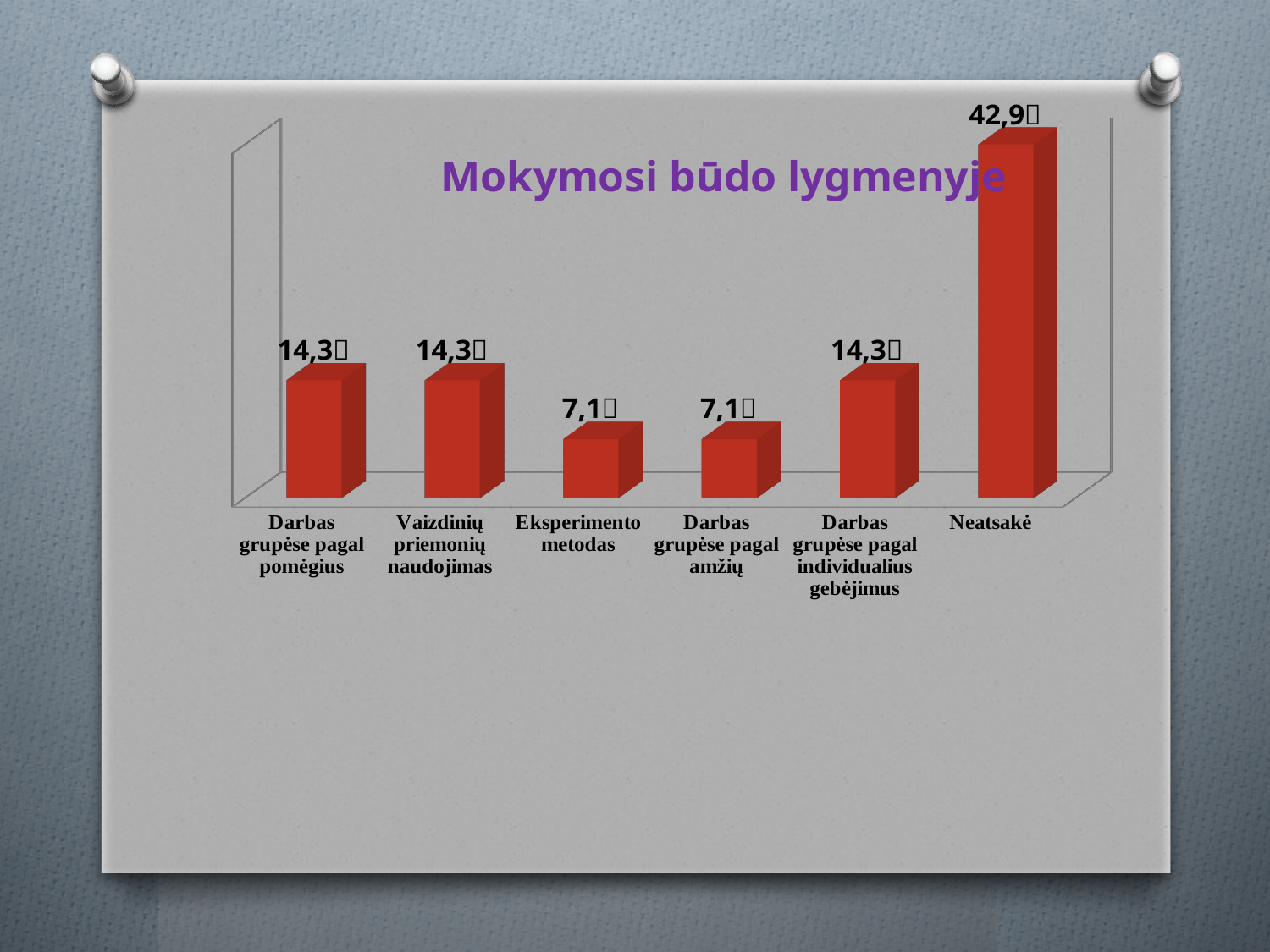
What is the difference between the values for Darbas grupėse pagal pomėgius and Eksperimento metodas? 7,2 Which category has the highest value? Neatsakė What is the value for Darbas grupėse pagal individualius gebėjimus? 14,3 How many categories are shown in the chart? 6 What is the title of the chart? Mokymosi būdo lygmenyje What is the difference between the values for Neatsakė and Vaizdinių priemonių naudojimas? 28,6 What is the value for Darbas grupėse pagal pomėgius? 14,3 Which is larger, the value for Vaizdinių priemonių naudojimas or the value for Darbas grupėse pagal amžių? Vaizdinių priemonių naudojimas What is the value for Eksperimento metodas? 7,1 What kind of chart is shown on the slide? Bar chart What is the value for Neatsakė? 42,9 What is the value for Darbas grupėse pagal amžių? 7,1